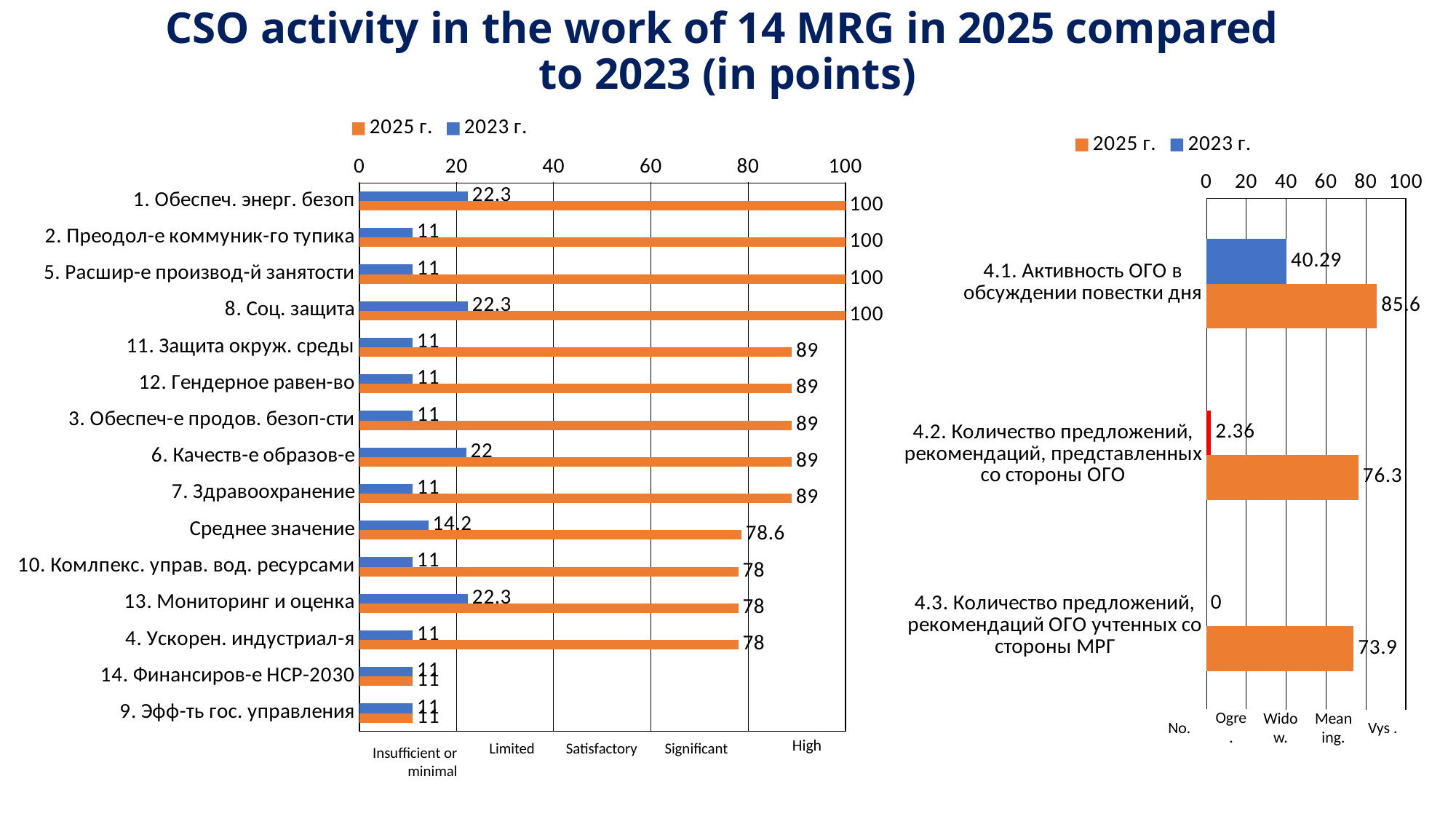
On the right chart, what is the difference between the 2025 г. and 2023 г. values for "4.1. Активность ОГО в обсуждении повестки дня"? 45.31 What type of chart is the left chart? Bar chart On the left chart, what is the 2023 г. value for "1. Обеспеч. энерг. безоп"? 22.3 On the right chart, what is the 2025 г. value for "4.2. Количество предложений, рекомендаций, представленных со стороны ОГО"? 76.3 How many series does the legend of the right chart list? 2 On the left chart, which is larger for "13. Мониторинг и оценка": the 2025 г. value or the 2023 г. value? 2025 г. On the left chart, how many categories are listed on the vertical axis? 15 On the left chart, what is the 2023 г. value for "6. Качеств-е образов-е"? 22 On the right chart, what is the 2023 г. value for "4.1. Активность ОГО в обсуждении повестки дня"? 40.29 On the right chart, which category has the highest 2025 г. value? 4.1. Активность ОГО в обсуждении повестки дня On the left chart, what is the 2025 г. value for "Среднее значение"? 78.6 On the left chart, what is the difference between the 2025 г. and 2023 г. values for "Среднее значение"? 64.4